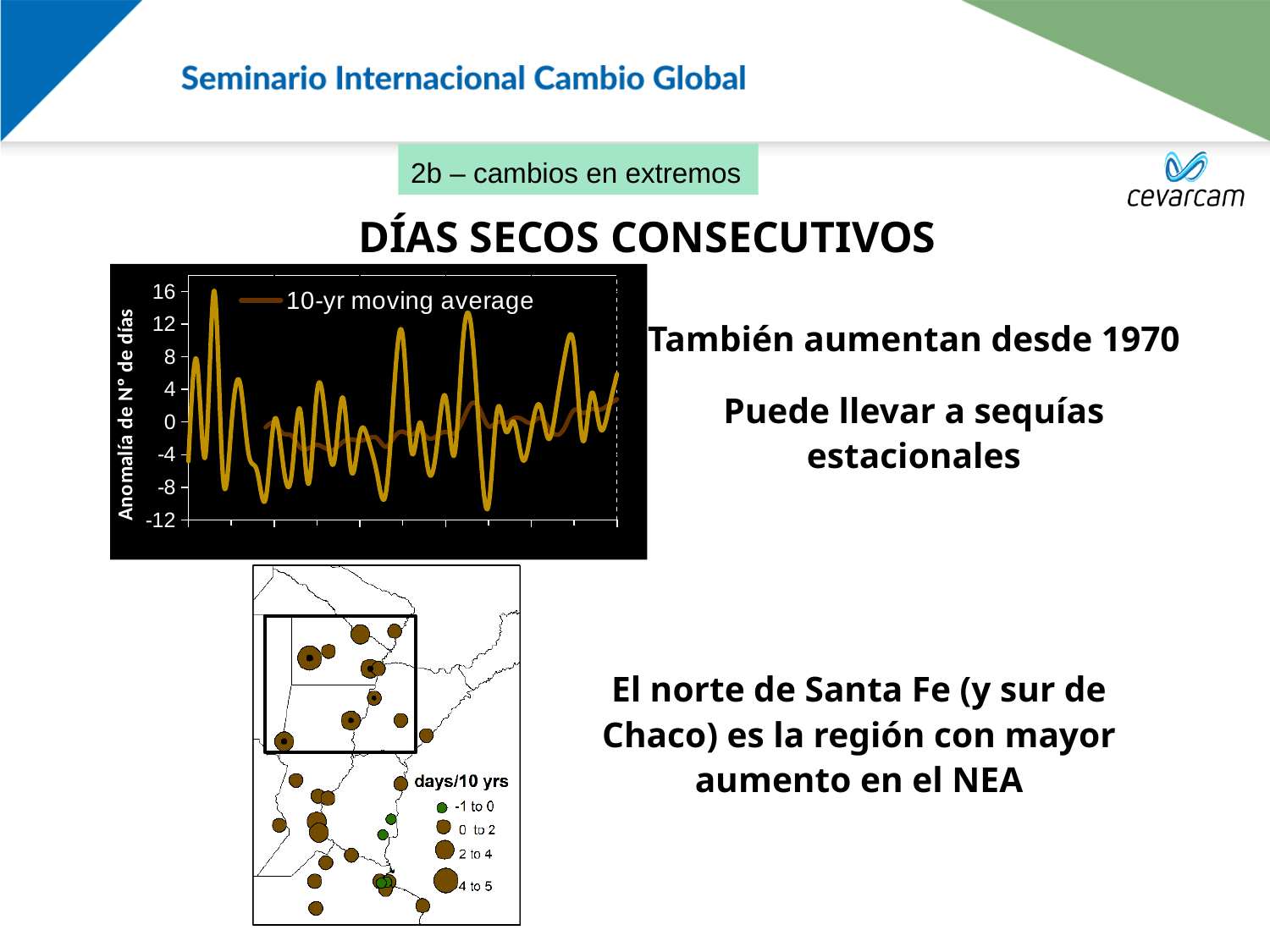
In the map chart at the bottom left, what is the title of the bubble-size legend? days/10 yrs In the top-left line chart, what series does the legend name? 10-yr moving average In the map chart at the bottom left, which legend category is shown with the smallest circle? -1 to 0 In the top-left line chart, how many series does the legend list? 1 In the top-left line chart, is the lowest point of the yellow line greater or less than -8? less In the map chart at the bottom left, how many size categories does the legend list? 4 In the top-left line chart, does the 10-yr moving average line rise or fall toward the right end of the chart? rise In the top-left line chart, is the 10-yr moving average line ever greater or less than 8? less In the map chart at the bottom left, which legend category is shown with the largest circle? 4 to 5 In the top-left line chart, is the highest peak of the yellow line greater or less than 12? greater What kind of chart is the chart at the top left of the slide, under the title 'DÍAS SECOS CONSECUTIVOS'? line chart